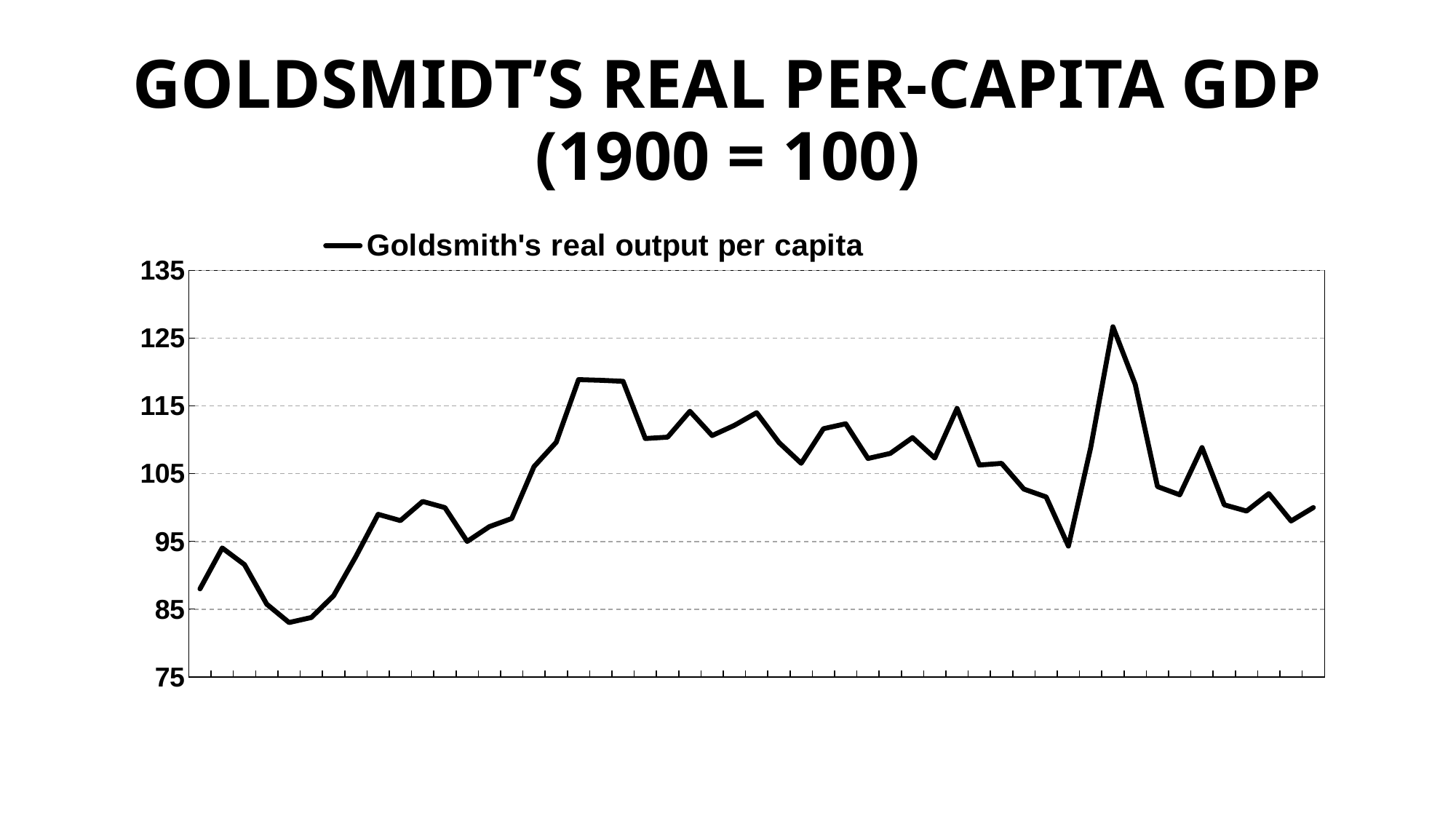
Is the highest value reached by the line greater or less than 120? greater Is the value at the start of the line higher or lower than the value at the end of the line? lower What kind of chart is shown on the slide? line chart What is the name of the series shown in the legend? Goldsmith's real output per capita Does the line rise or fall between its first point and its highest peak? rise Is the last value of the line greater or less than 105? less Is the first value of the line greater or less than 95? less What is the title of the chart on the slide? GOLDSMIDT'S REAL PER-CAPITA GDP (1900 = 100) What is the lowest value shown on the vertical axis? 75 How many series does the legend list? 1